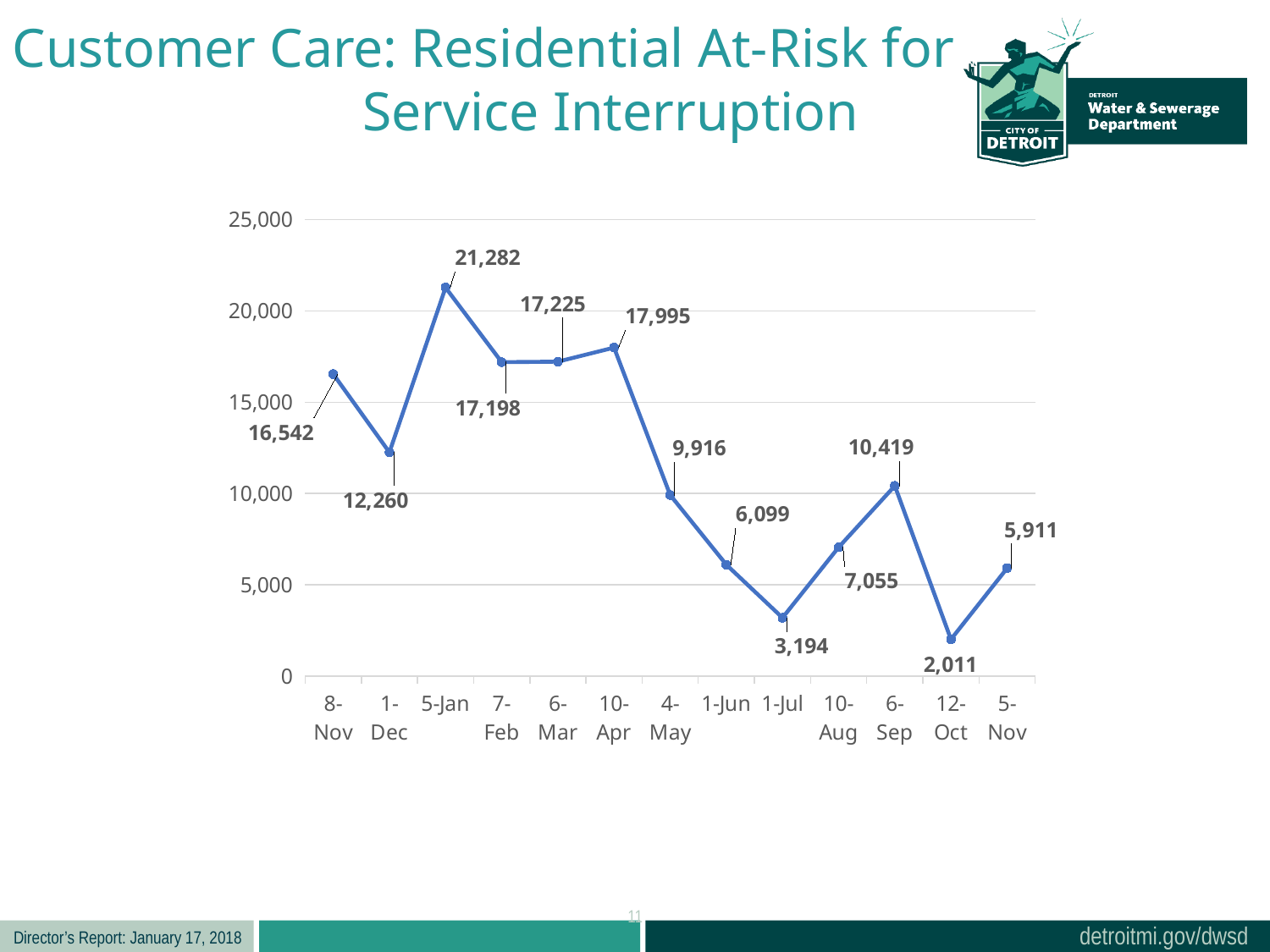
What is the value for 5-Jan? 21,282 Which date has the highest value? 5-Jan What is the title of the slide containing the chart? Customer Care: Residential At-Risk for Service Interruption What kind of chart is shown on the slide? line chart Which is larger, the value for 10-Aug or the value for 1-Jun? 10-Aug What is the difference between the values for 8-Nov and 1-Dec? 4,282 Do the values rise or fall from 10-Apr to 1-Jul? fall What is the value for 1-Jul? 3,194 Which date has the lowest value? 12-Oct What is the value for 6-Sep? 10,419 Is the value for 10-Apr greater or less than 15,000? greater How many data points are plotted on the chart? 13